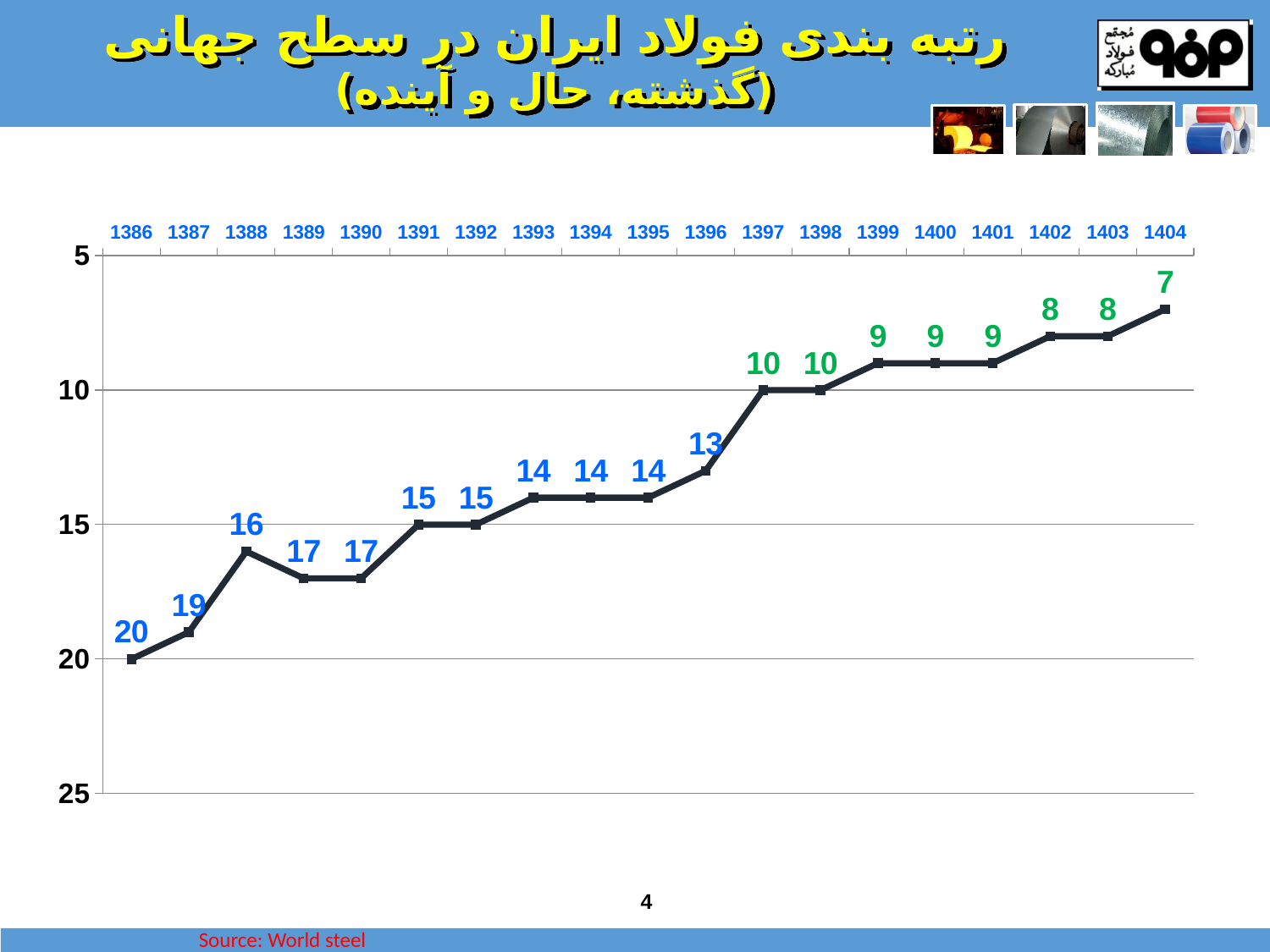
What is the value for 1391? 15 Which year has the highest plotted value? 1386 What is the difference between the values for 1386 and 1404? 13 What is the value for 1386? 20 Do the plotted values rise or fall from 1386 to 1404? fall Which is larger, the value for 1388 or the value for 1389? 1389 What source is cited at the bottom of the slide? World steel What is the value for 1396? 13 How many years are plotted on the chart? 19 What is the value for 1404? 7 What kind of chart is shown on the slide? line chart Which year has the lowest plotted value? 1404